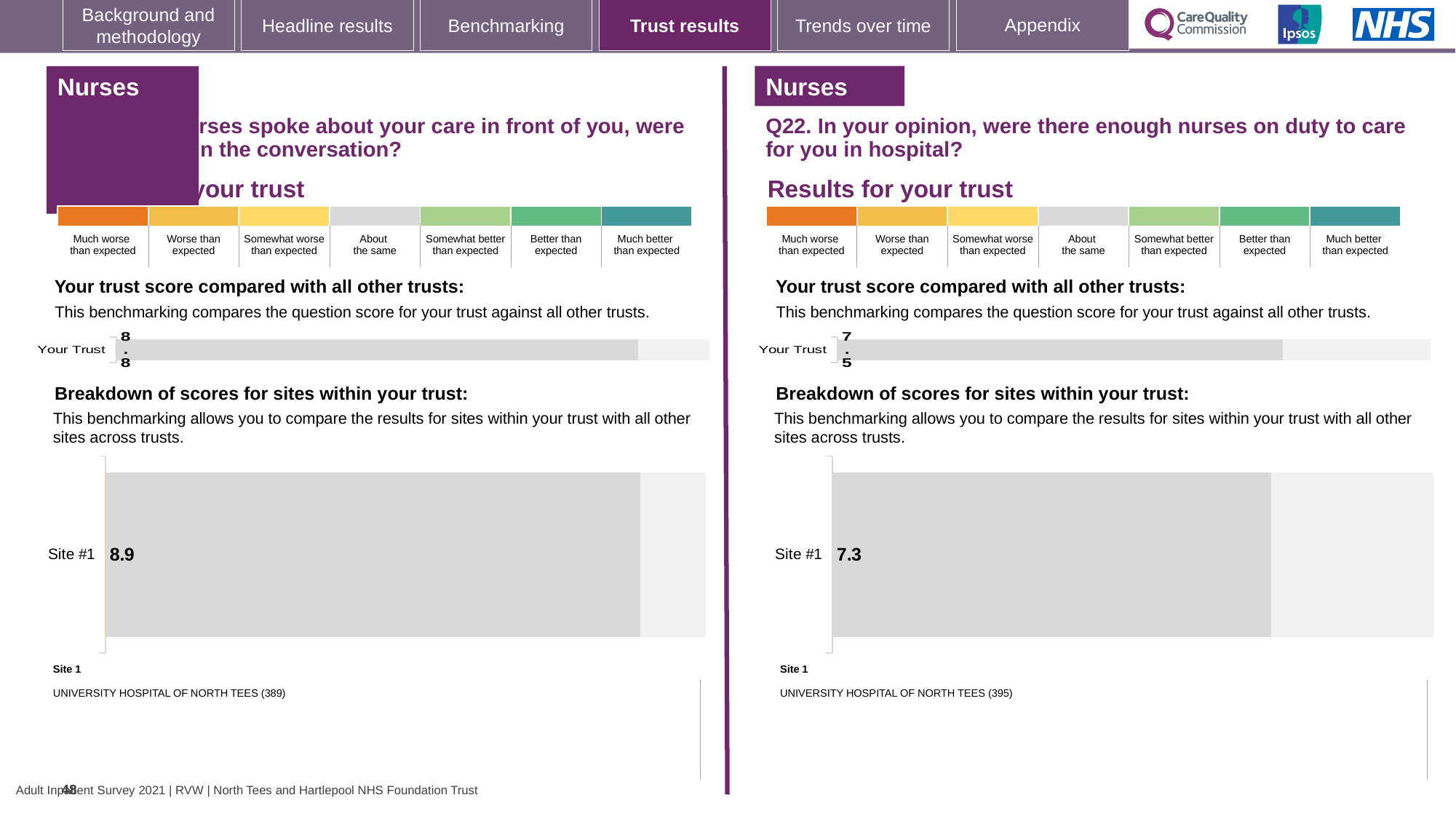
For Q22 (enough nurses on duty), what is the 'Your Trust' score shown in the trust benchmarking bar chart? 7.5 On the left half of the slide, what score is shown for Site #1 in the site breakdown bar chart? 8.9 On the left half of the slide, what is the difference between the Site #1 score and the 'Your Trust' score? 0.1 For Q22, what is the difference between the 'Your Trust' score and the Site #1 score? 0.2 Which is larger: the Site #1 score on the left half of the slide or the Site #1 score for Q22 on the right? Site #1 on the left (8.9) On the left half of the slide, what is the 'Your Trust' score shown in the trust benchmarking bar chart? 8.8 What kind of chart is used to show the Site #1 score in the site breakdown on the right half of the slide? Bar chart How many categories are shown in the colour scale above the 'Results for your trust' section for Q22? 7 How many sites are shown in the site breakdown chart for Q22? 1 For Q22, is the 'Your Trust' score or the Site #1 score larger? Your Trust (7.5) Which site is listed as Site 1 beneath the Q22 site breakdown chart? UNIVERSITY HOSPITAL OF NORTH TEES (395) For Q22 (enough nurses on duty), what score is shown for Site #1 in the site breakdown bar chart? 7.3